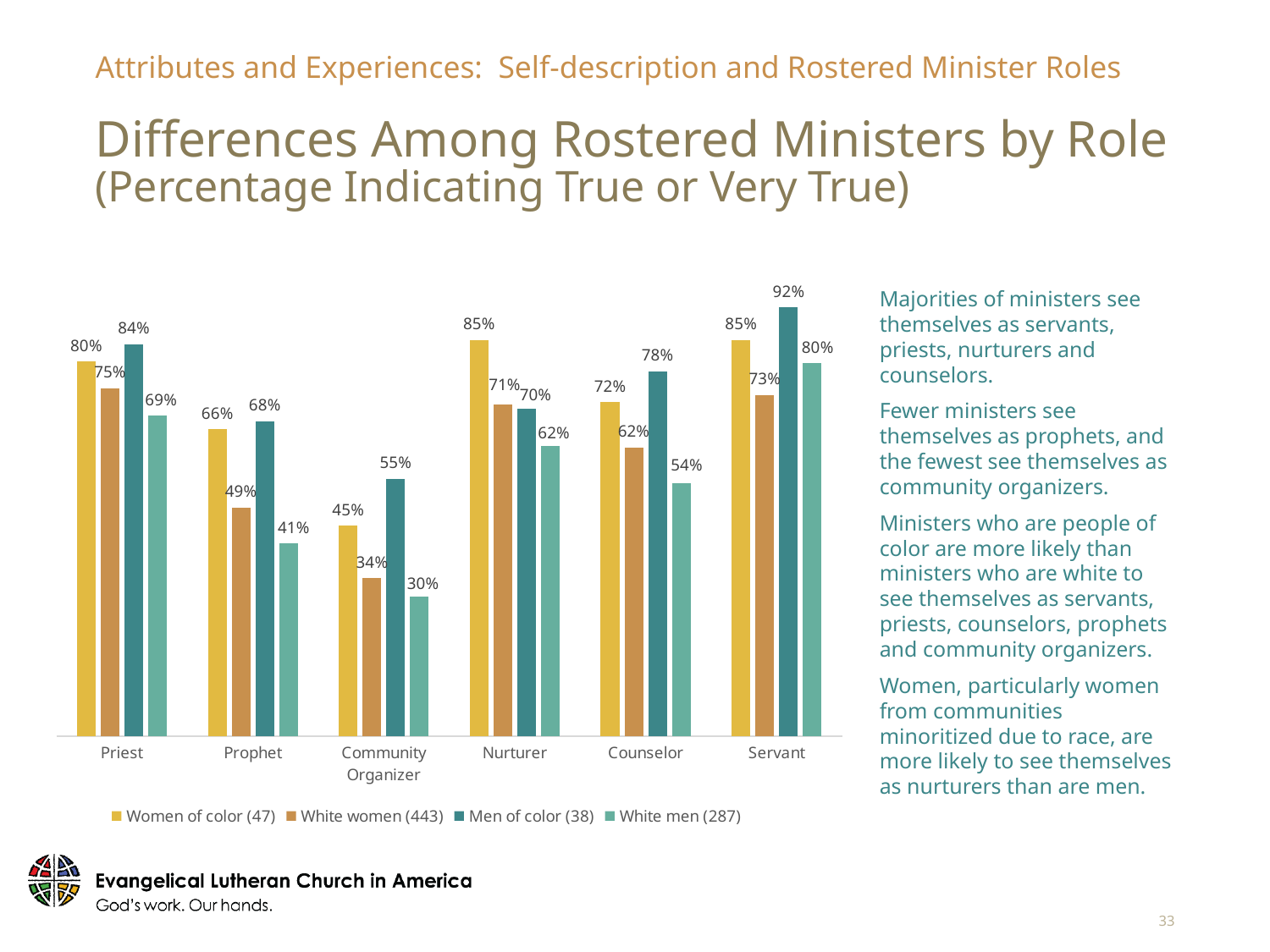
What is the difference between Men of color and White men in the Servant category? 12% Which category has the lowest value for White men? Community Organizer Which is larger in the Counselor category: the value for Women of color or the value for White women? Women of color What kind of chart is shown on the slide? Bar chart Which series has the highest value in the Priest category? Men of color (38) How many role categories are shown on the x axis? 6 What is the value for White women in the Prophet category? 49% What percentage of Men of color indicated True or Very True for Servant? 92% What is the value for White men in the Community Organizer category? 30% How many series does the legend list? 4 What percentage of Women of color described themselves as Nurturer? 85% What is the sample size shown in the legend for White women? 443